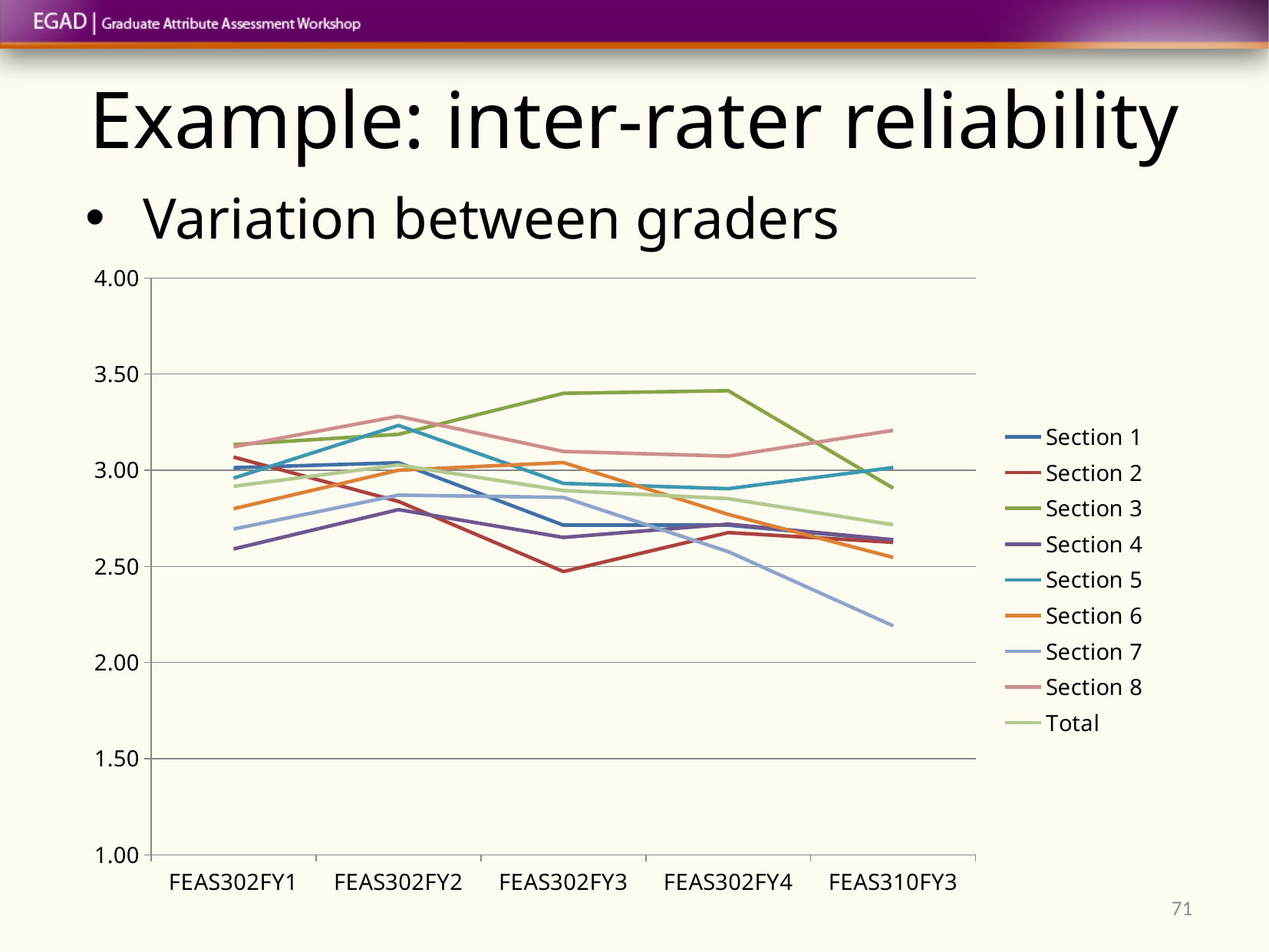
Which series has the highest value at FEAS302FY4? Section 3 How many series does the legend list? 9 Is the value for Section 7 at FEAS310FY3 greater or less than 2.50? less Which series has the lowest value at FEAS302FY3? Section 2 Which series has the highest value at FEAS310FY3? Section 8 How many categories are shown on the x axis? 5 At FEAS310FY3, which is larger: the value for Section 3 or the value for Section 7? Section 3 What kind of chart is shown on the slide? line chart Is the value for Section 3 at FEAS302FY3 greater or less than 3.00? greater Does the Section 7 line rise or fall from FEAS302FY2 to FEAS310FY3? fall Which series has the lowest value at FEAS310FY3? Section 7 Is the value for Section 8 at FEAS302FY2 greater or less than 3.00? greater